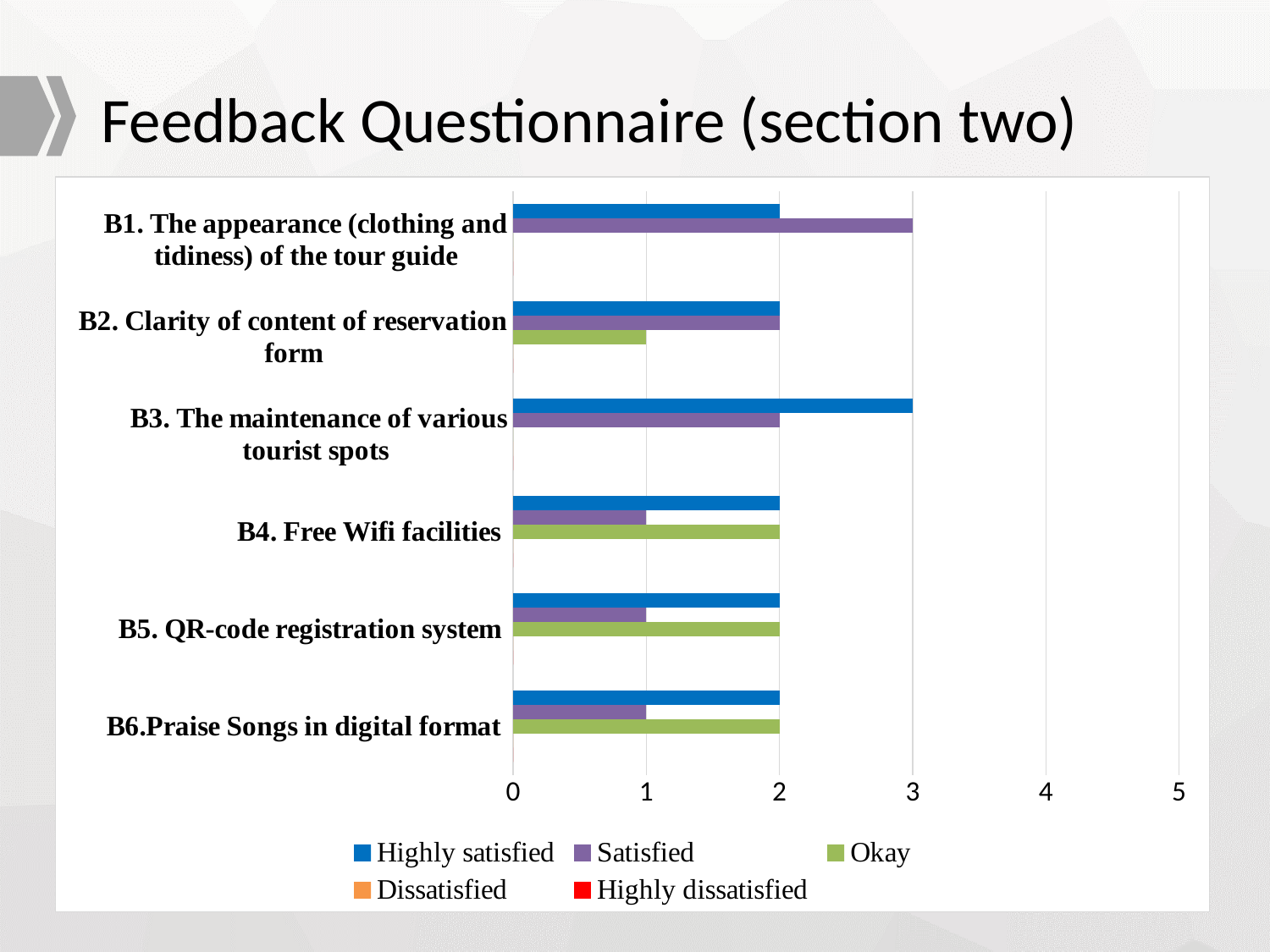
Which category has the highest Highly satisfied value? B3. The maintenance of various tourist spots Which is larger for B5. QR-code registration system: the Highly satisfied value or the Satisfied value? Highly satisfied Which category has the highest Satisfied value? B1. The appearance (clothing and tidiness) of the tour guide How many categories (questionnaire items) are shown on the chart? 6 What is the Highly satisfied value for B3. The maintenance of various tourist spots? 3 How many series does the legend list? 5 What is the Okay value for B2. Clarity of content of reservation form? 1 Which legend entry is shown in green? Okay What kind of chart is shown on the slide? Bar chart What is the Satisfied value for B4. Free Wifi facilities? 1 What is the Satisfied value for B1. The appearance (clothing and tidiness) of the tour guide? 3 What is the difference between the Satisfied value for B1 and the Satisfied value for B4? 2